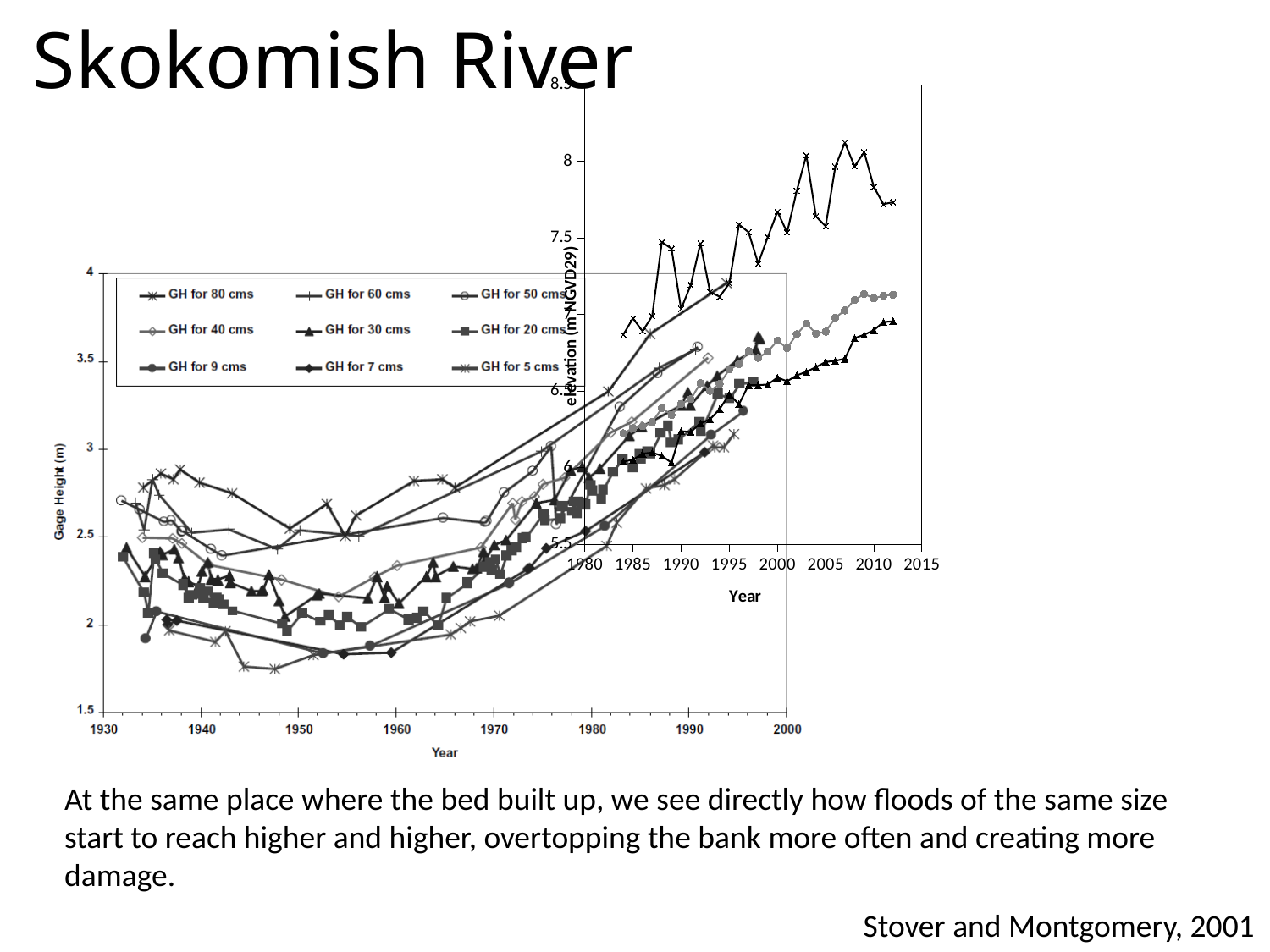
In the smaller elevation chart, do the plotted values generally rise or fall from 1985 to 2012? rise In the large Gage Height chart, is the value for GH for 80 cms around 1937 greater or less than 2.5? greater In the smaller elevation chart, how many lines are plotted? 3 In the large Gage Height chart, how many series does the legend list? 9 In the large Gage Height chart, does the GH for 80 cms series rise or fall between 1960 and 2000? rise What kind of chart is the smaller chart with the y axis labelled elevation (m NGVD29)? line chart What kind of chart is the large chart with the y axis labelled Gage Height (m)? line chart In the large Gage Height chart, which series is listed first in the legend? GH for 80 cms In the smaller elevation chart, is the value of the top (x-marker) series around 2007 greater or less than 8? greater In the large Gage Height chart, what is the label of the y axis? Gage Height (m) In the large Gage Height chart, is the value for GH for 5 cms around 1945 greater or less than 2? less